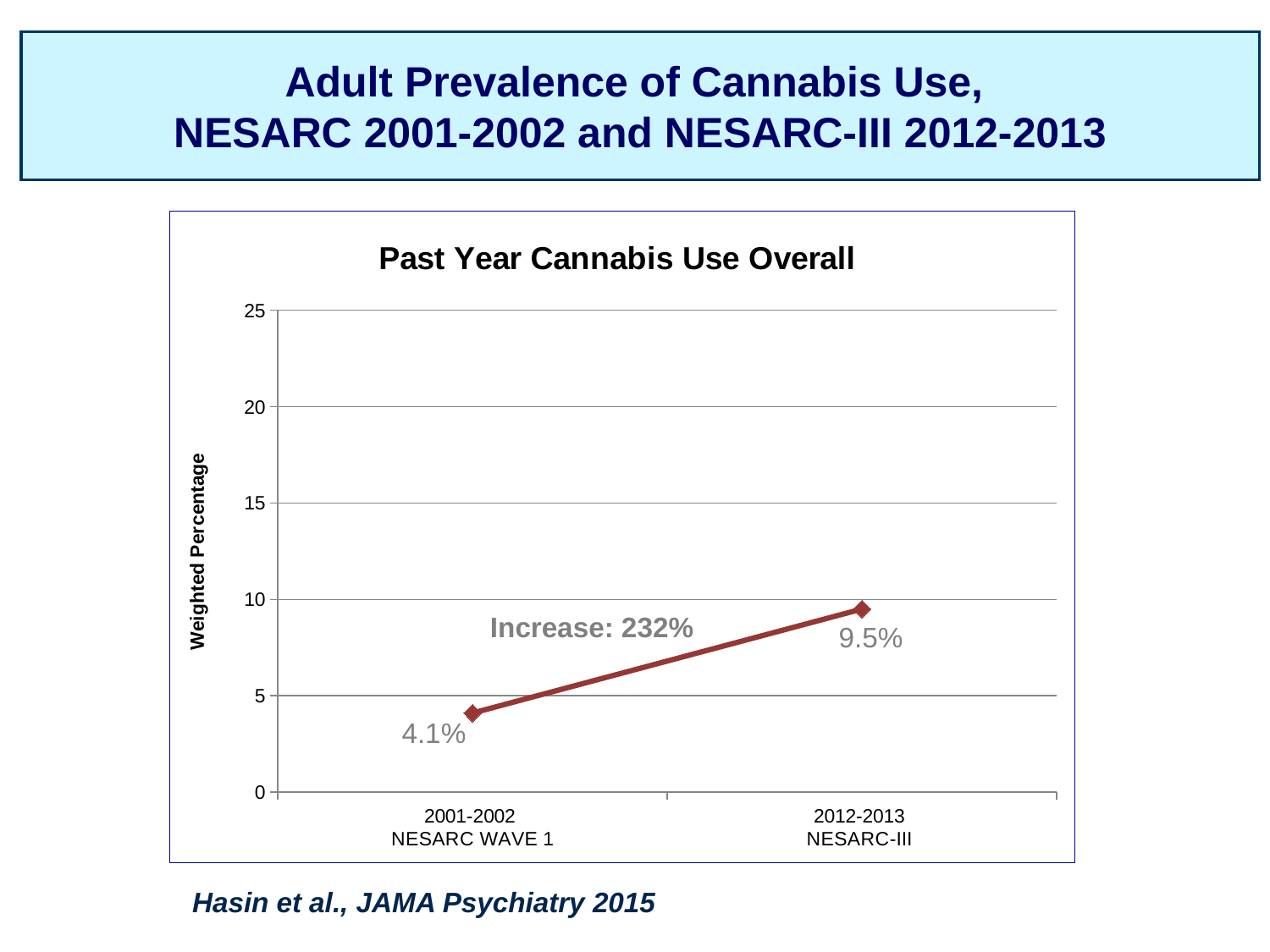
What percentage increase is annotated on the chart? 232% Does past year cannabis use rise or fall from 2001-2002 to 2012-2013? rise What is the past year cannabis use value for 2001-2002 NESARC WAVE 1? 4.1% Which survey wave has the higher past year cannabis use? 2012-2013 NESARC-III Is the past year cannabis use value for 2012-2013 NESARC-III greater or less than 10? less What is the title of the chart? Past Year Cannabis Use Overall What is the difference in past year cannabis use between 2012-2013 NESARC-III and 2001-2002 NESARC WAVE 1? 5.4% Which survey wave has the lower past year cannabis use? 2001-2002 NESARC WAVE 1 What is the past year cannabis use value for 2012-2013 NESARC-III? 9.5% Is the past year cannabis use value for 2001-2002 NESARC WAVE 1 greater or less than 5? less How many data points are plotted on the chart? 2 What kind of chart is shown on the slide? line chart